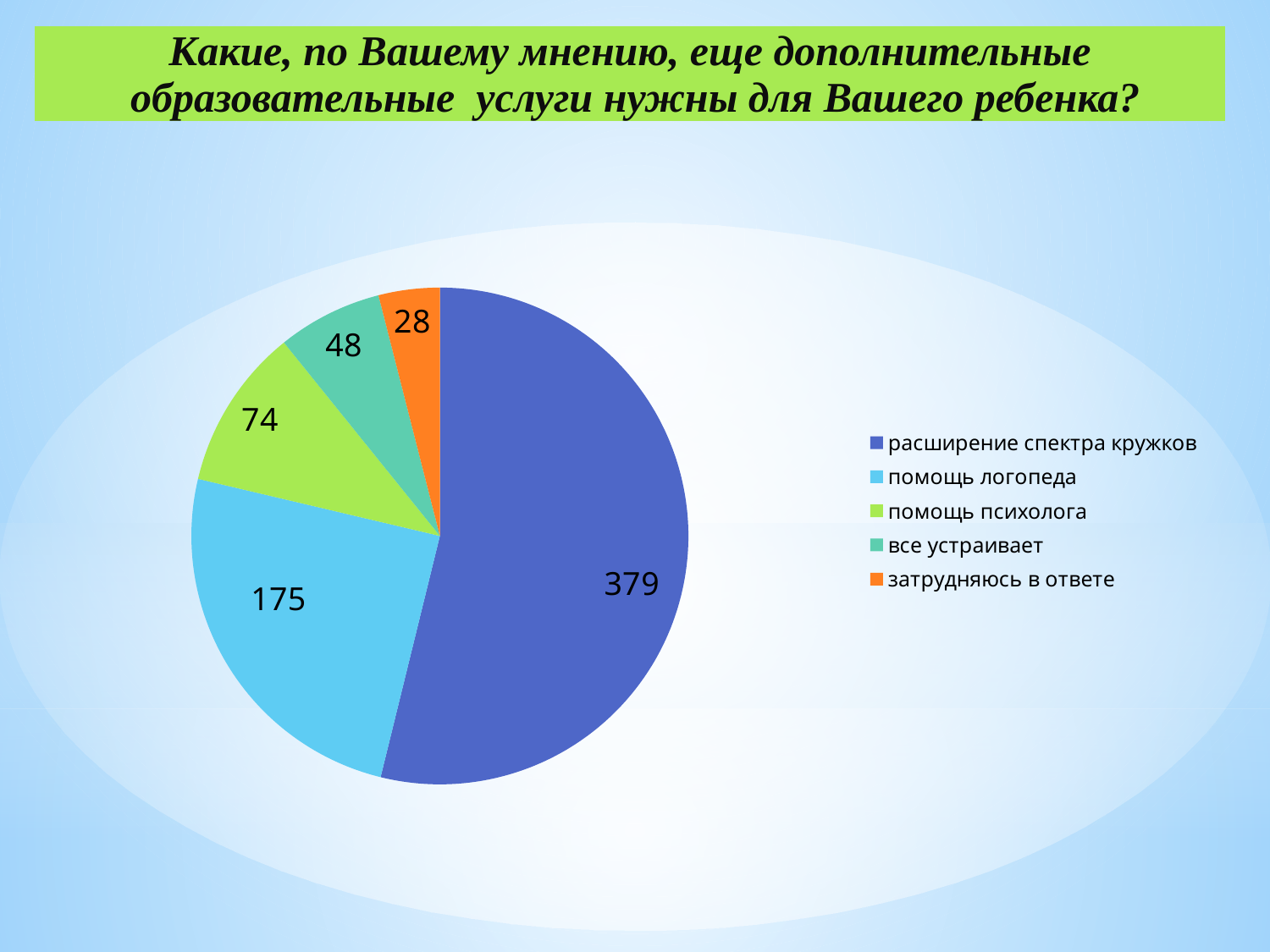
What colour is the slice for "затрудняюсь в ответе"? orange Which category has the largest slice of the pie? расширение спектра кружков What is the difference between the values for "расширение спектра кружков" and "помощь логопеда"? 204 Which category has the smallest slice of the pie? затрудняюсь в ответе Which is larger: the value for "помощь психолога" or the value for "все устраивает"? помощь психолога What type of chart is shown on the slide? pie chart What is the value for "затрудняюсь в ответе"? 28 What is the value for "все устраивает"? 48 What is the value for "помощь логопеда"? 175 What is the value for "помощь психолога"? 74 What is the value for "расширение спектра кружков"? 379 How many categories does the pie chart have? 5